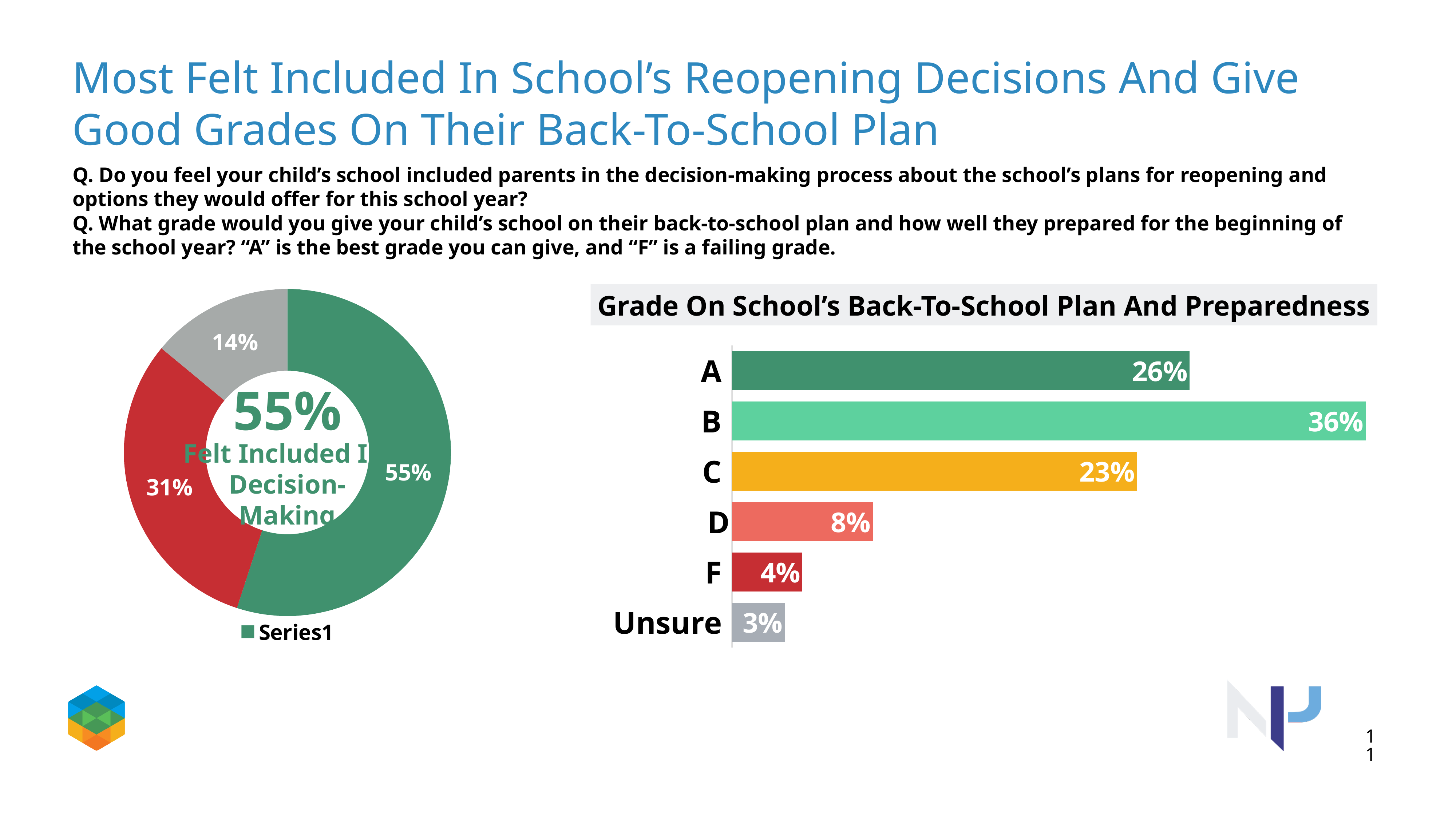
In the chart titled 'Grade On School's Back-To-School Plan And Preparedness', how many categories are shown? 6 In the chart titled 'Grade On School's Back-To-School Plan And Preparedness', what is the difference between the percentages for B and A? 10% What kind of chart is the chart titled 'Grade On School's Back-To-School Plan And Preparedness'? Bar chart In the chart titled 'Grade On School's Back-To-School Plan And Preparedness', what percentage gave a grade of B? 36% In the chart titled 'Grade On School's Back-To-School Plan And Preparedness', which category has the lowest percentage? Unsure In the chart titled 'Grade On School's Back-To-School Plan And Preparedness', which grade has the highest percentage? B In the chart titled 'Grade On School's Back-To-School Plan And Preparedness', which is larger, the percentage for C or the percentage for D? C In the chart titled 'Grade On School's Back-To-School Plan And Preparedness', what percentage gave a grade of A? 26% How many slices does the donut chart on the left of the slide have? 3 In the chart titled 'Grade On School's Back-To-School Plan And Preparedness', what percentage answered Unsure? 3% In the donut chart on the left of the slide, what is the value of the largest slice? 55% What legend entry is shown below the donut chart on the left of the slide? Series1